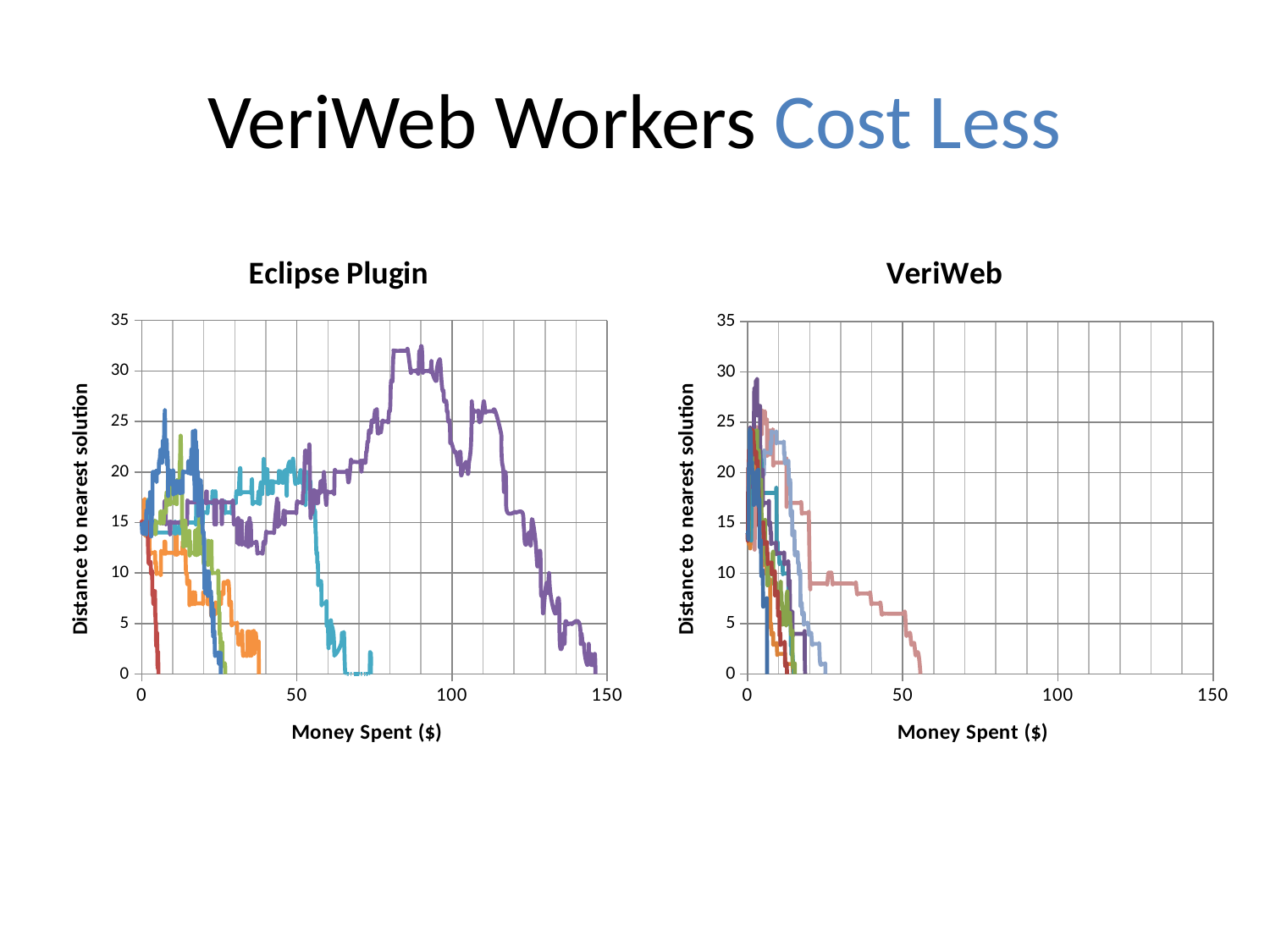
What is the maximum value shown on the y axis of the VeriWeb chart? 35 In the Eclipse Plugin chart, does the purple line rise or fall between money spent of 100 and 150? fall What is the x-axis label of the VeriWeb chart? Money Spent ($) In the Eclipse Plugin chart, is the red line's ending money-spent value greater or less than 50? less In the Eclipse Plugin chart, is the peak of the purple line greater or less than 30 on the y axis? greater What kind of chart is the Eclipse Plugin chart? line chart In the VeriWeb chart, does the line that extends furthest along the x axis end at a money-spent value greater or less than 100? less Which chart has a line that reaches a money-spent value beyond 100: Eclipse Plugin or VeriWeb? Eclipse Plugin What is the title of the chart on the left side of the slide? Eclipse Plugin What kind of chart is the VeriWeb chart? line chart